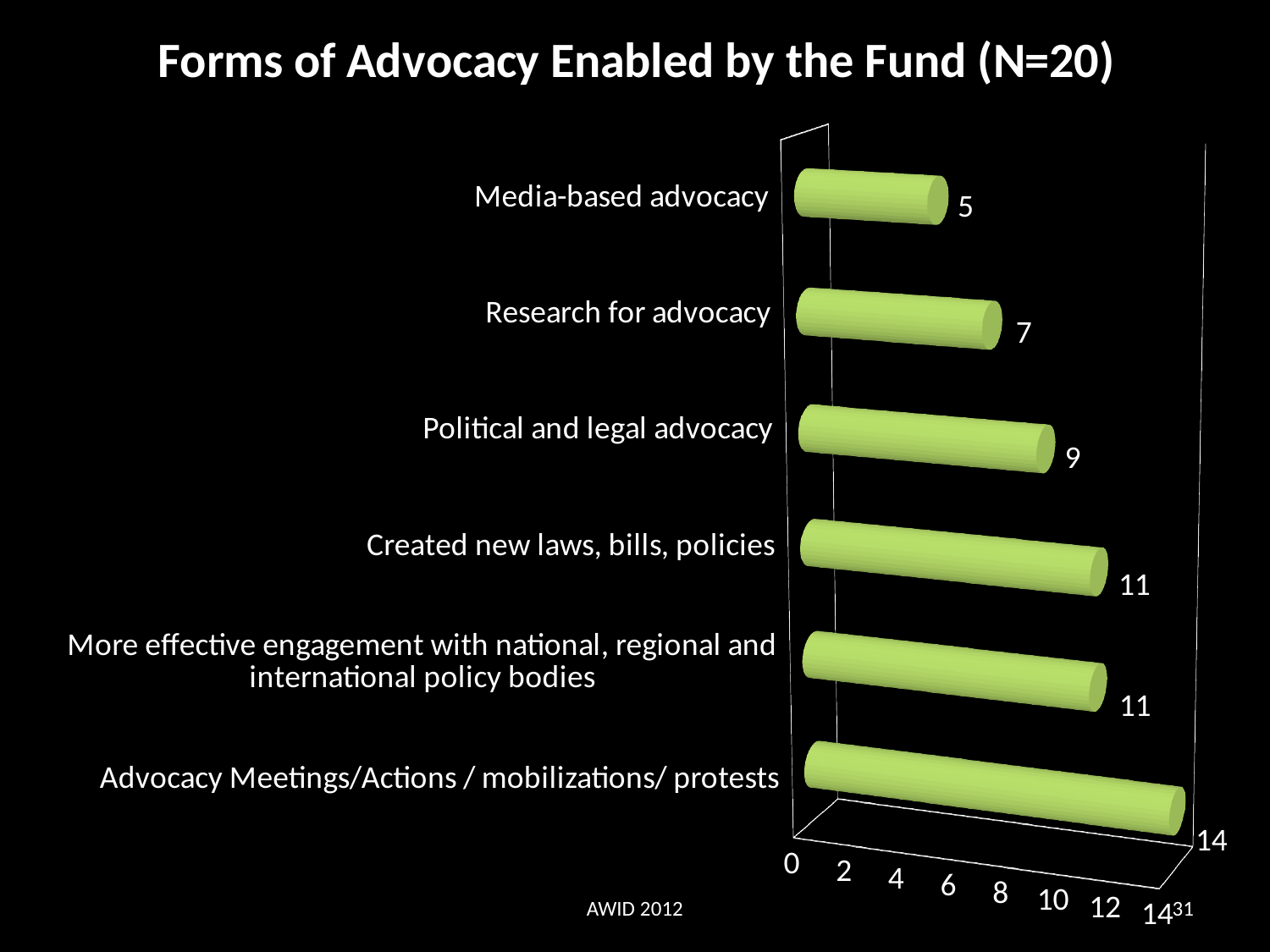
Which is larger, the value for Political and legal advocacy or the value for Research for advocacy? Political and legal advocacy Which category has the lowest value? Media-based advocacy What is the difference between the values for Created new laws, bills, policies and Research for advocacy? 4 What kind of chart is shown on the slide? Bar chart What is the value for Media-based advocacy? 5 What is the value for Advocacy Meetings/Actions / mobilizations/ protests? 14 What is the value for Research for advocacy? 7 What is the difference between the values for Advocacy Meetings/Actions / mobilizations/ protests and Media-based advocacy? 9 What is the title of the chart? Forms of Advocacy Enabled by the Fund (N=20) How many categories are shown in the chart? 6 Which category has the highest value? Advocacy Meetings/Actions / mobilizations/ protests What is the value for Political and legal advocacy? 9